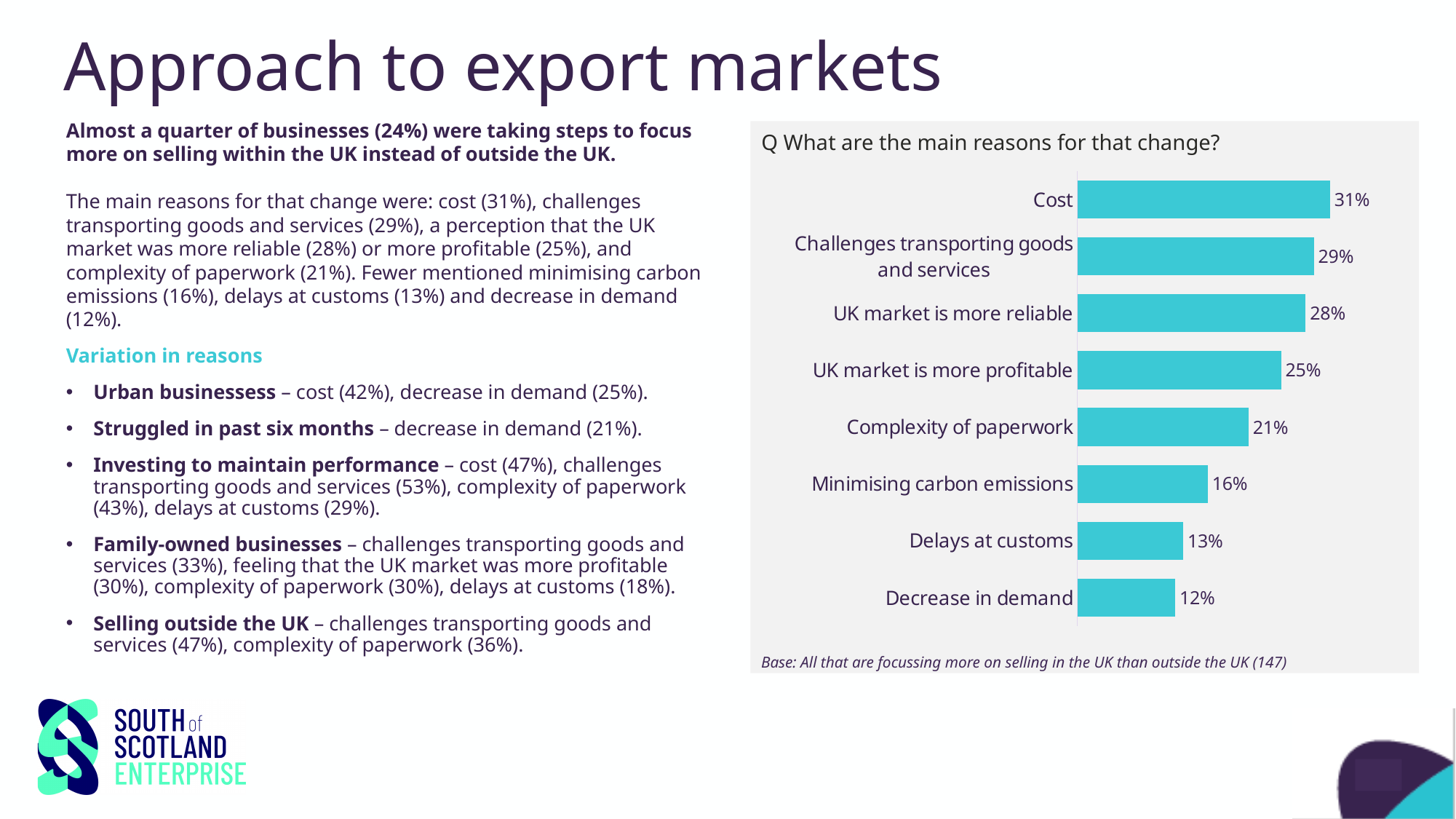
Which is larger: the value for 'Complexity of paperwork' or the value for 'Minimising carbon emissions'? Complexity of paperwork What is the difference in percentage points between 'UK market is more reliable' and 'UK market is more profitable'? 3 Which reason has the lowest percentage in the chart? Decrease in demand What is the value shown for 'Delays at customs'? 13% What question does the chart title ask? Q What are the main reasons for that change? How many reasons (categories) are shown in the chart? 8 What percentage is shown for 'Minimising carbon emissions'? 16% What is the difference in percentage points between 'Cost' and 'Decrease in demand'? 19 What percentage of businesses cited cost as a main reason for the change? 31% What kind of chart is used to show the main reasons for the change? Bar chart Which reason has the highest percentage in the chart? Cost What is the base size stated beneath the chart? 147